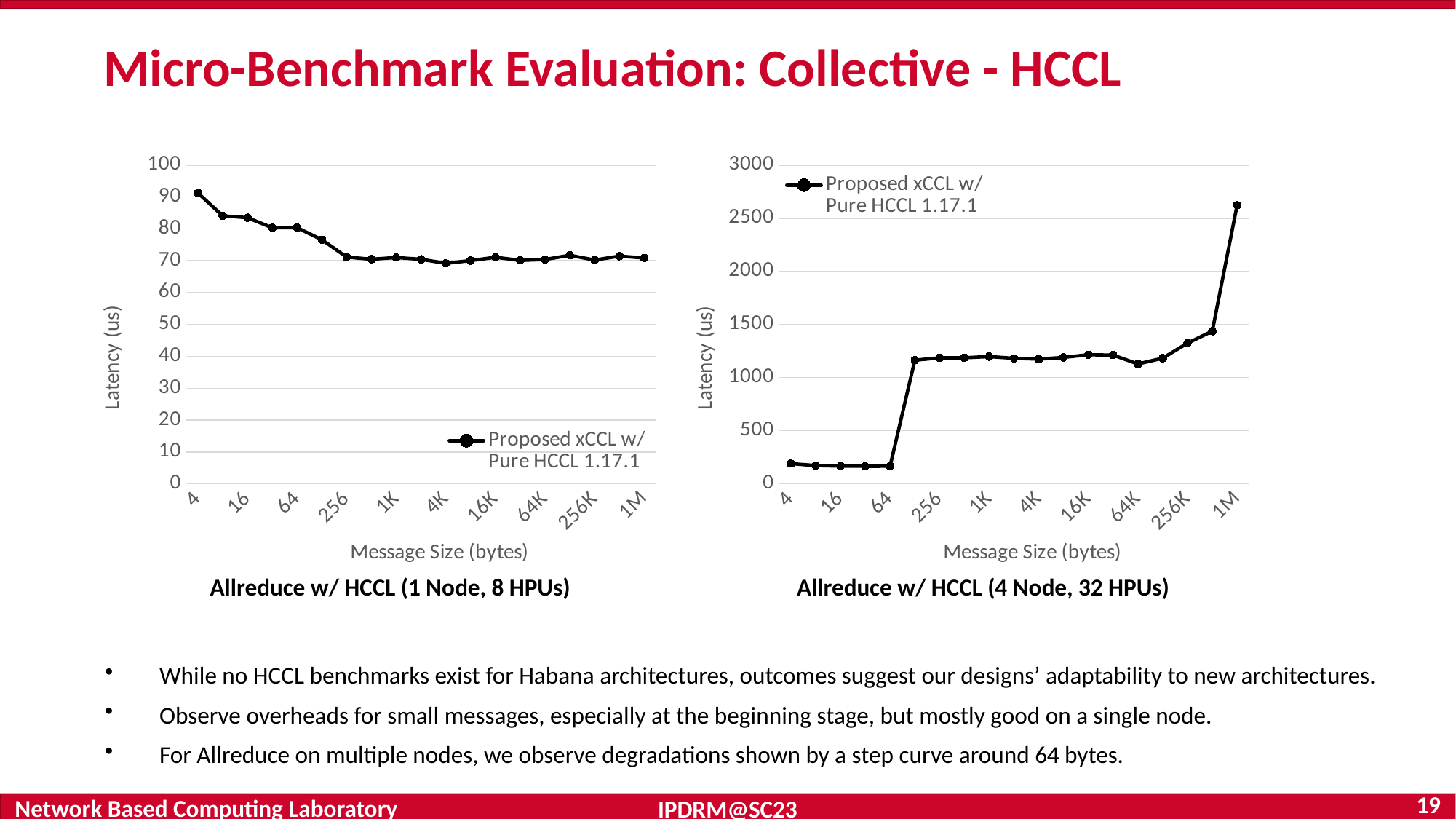
In the 'Allreduce w/ HCCL (1 Node, 8 HPUs)' chart, is the latency at message size 1M greater or less than 80? less What kind of chart is the 'Allreduce w/ HCCL (1 Node, 8 HPUs)' chart? line chart In the 'Allreduce w/ HCCL (4 Node, 32 HPUs)' chart, is the latency at message size 256 greater or less than 1000? greater In the 'Allreduce w/ HCCL (1 Node, 8 HPUs)' chart, at which message size is latency highest? 4 How many series does the legend list in the 'Allreduce w/ HCCL (4 Node, 32 HPUs)' chart? 1 In the 'Allreduce w/ HCCL (1 Node, 8 HPUs)' chart, what is the legend entry for the plotted series? Proposed xCCL w/ Pure HCCL 1.17.1 In the 'Allreduce w/ HCCL (4 Node, 32 HPUs)' chart, is the latency at message size 4 greater or less than 500? less In the 'Allreduce w/ HCCL (4 Node, 32 HPUs)' chart, at which message size is latency highest? 1M In the 'Allreduce w/ HCCL (4 Node, 32 HPUs)' chart, does latency generally rise or fall as message size increases? rise In the 'Allreduce w/ HCCL (1 Node, 8 HPUs)' chart, which has higher latency: message size 4 or message size 1M? 4